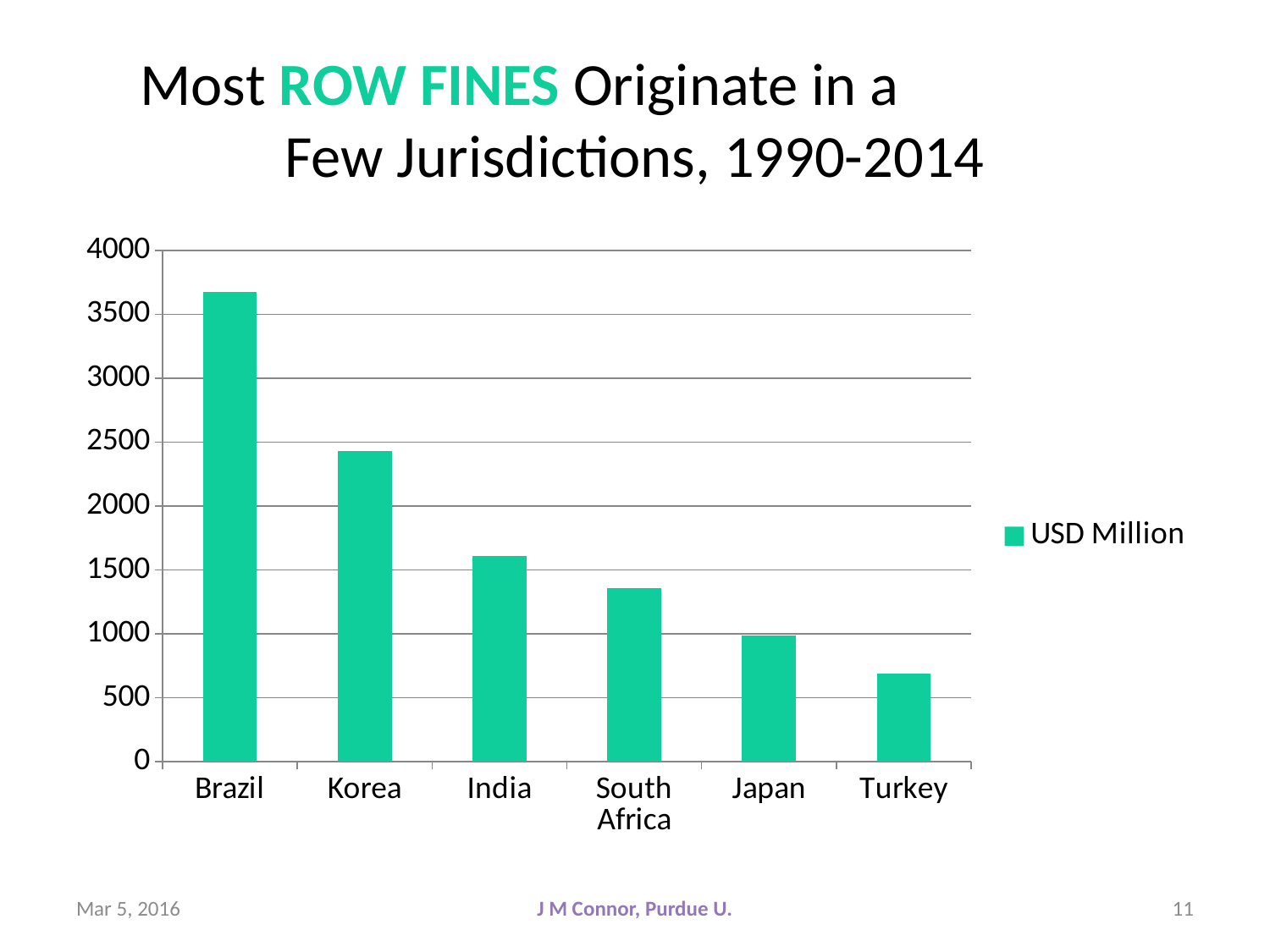
What kind of chart is shown on the slide? bar chart How many series does the legend list? 1 Which has a larger value, Korea or India? Korea Do the values rise or fall from Brazil to Turkey along the x axis? fall Is the value for Turkey greater or less than 1000? less How many countries are shown on the x axis of the chart? 6 Is the value for Korea greater or less than 2500? less Is the value for Brazil greater or less than 3500? greater Which has a larger value, South Africa or Japan? South Africa Which country has the highest bar in the chart? Brazil Which country has the lowest bar in the chart? Turkey